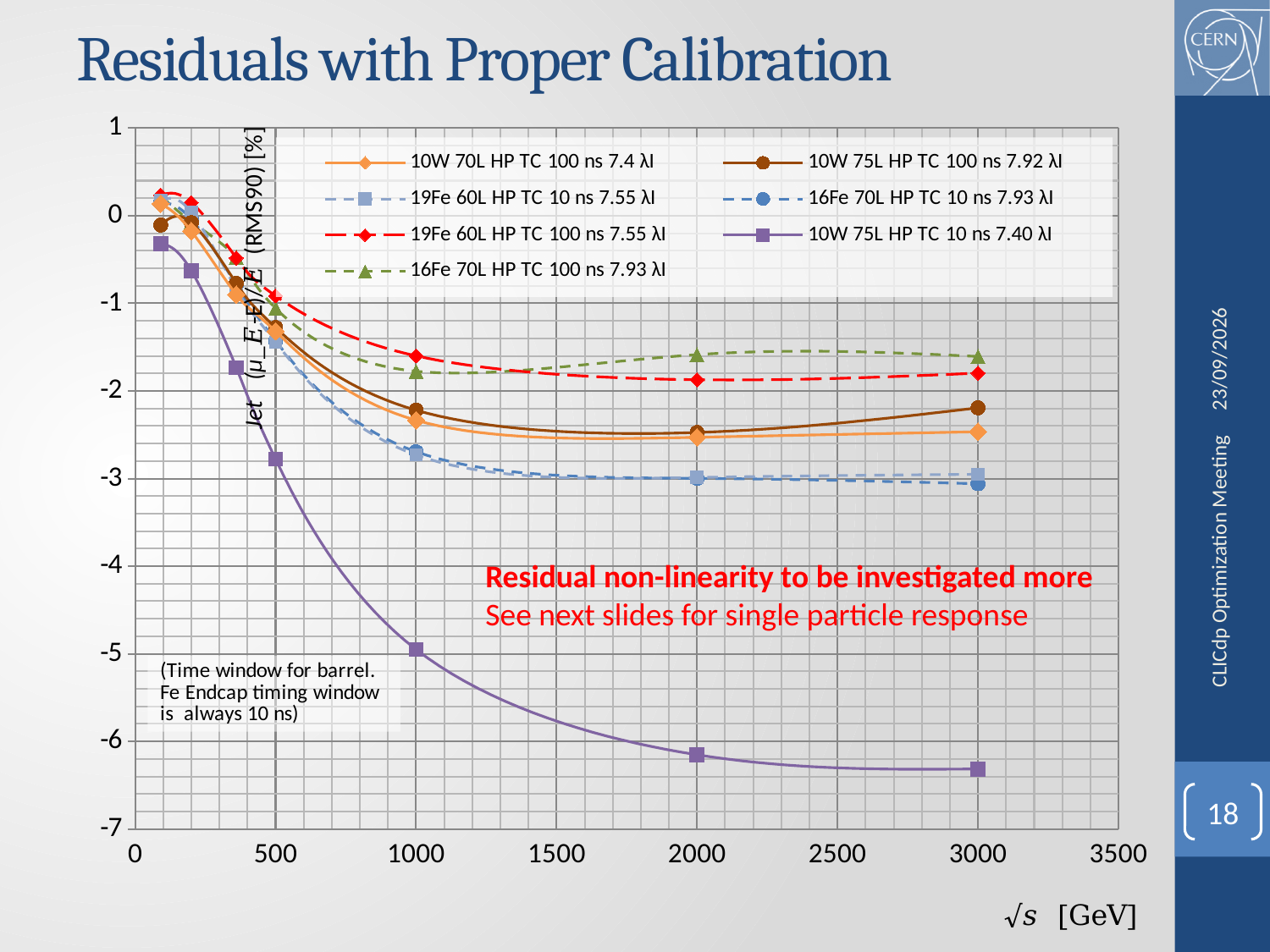
Is the value for 16Fe 70L HP TC 100 ns 7.93 λI at √s = 3000 GeV greater or less than -2? greater Is the value for 10W 75L HP TC 100 ns 7.92 λI at √s = 3000 GeV greater or less than -2? less Does the 10W 75L HP TC 10 ns 7.40 λI series rise or fall as √s increases from 500 to 3000 GeV? fall Is the value for 10W 75L HP TC 10 ns 7.40 λI at √s = 3000 GeV greater or less than -6? less How many data points does the 10W 75L HP TC 10 ns 7.40 λI series have? 7 What kind of chart is shown on the slide? line chart Which series has the lowest value at √s = 3000 GeV? 10W 75L HP TC 10 ns 7.40 λI At √s = 1000 GeV, which is larger: the value for 19Fe 60L HP TC 100 ns 7.55 λI or for 10W 75L HP TC 10 ns 7.40 λI? 19Fe 60L HP TC 100 ns 7.55 λI Which series has the highest value at √s = 3000 GeV? 16Fe 70L HP TC 100 ns 7.93 λI How many series does the legend list? 7 What is the title of the chart? Residuals with Proper Calibration